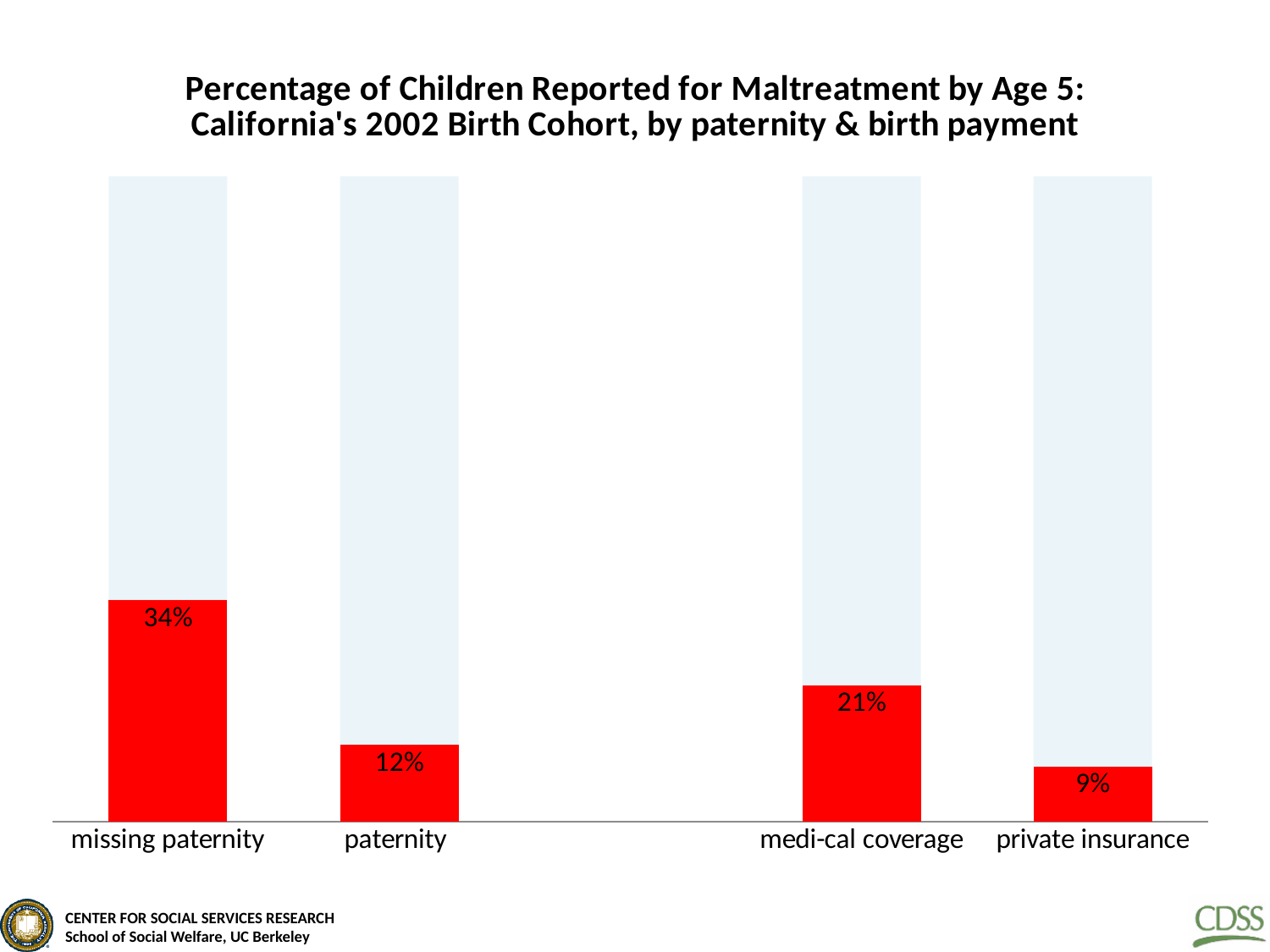
Which category has the highest percentage of children reported for maltreatment? missing paternity Which category has the lowest percentage? private insurance What kind of chart is shown on the slide? bar chart What is the value shown for the paternity category? 12% Which is larger, the value for medi-cal coverage or the value for paternity? medi-cal coverage How many categories are shown on the chart? 4 What is the difference between the medi-cal coverage and private insurance values? 12% Which birth cohort does the chart title refer to? California's 2002 Birth Cohort What is the difference between the missing paternity and paternity percentages? 22% What percentage is shown for medi-cal coverage? 21% What percentage of children with missing paternity were reported for maltreatment by age 5? 34% What is the value for private insurance? 9%